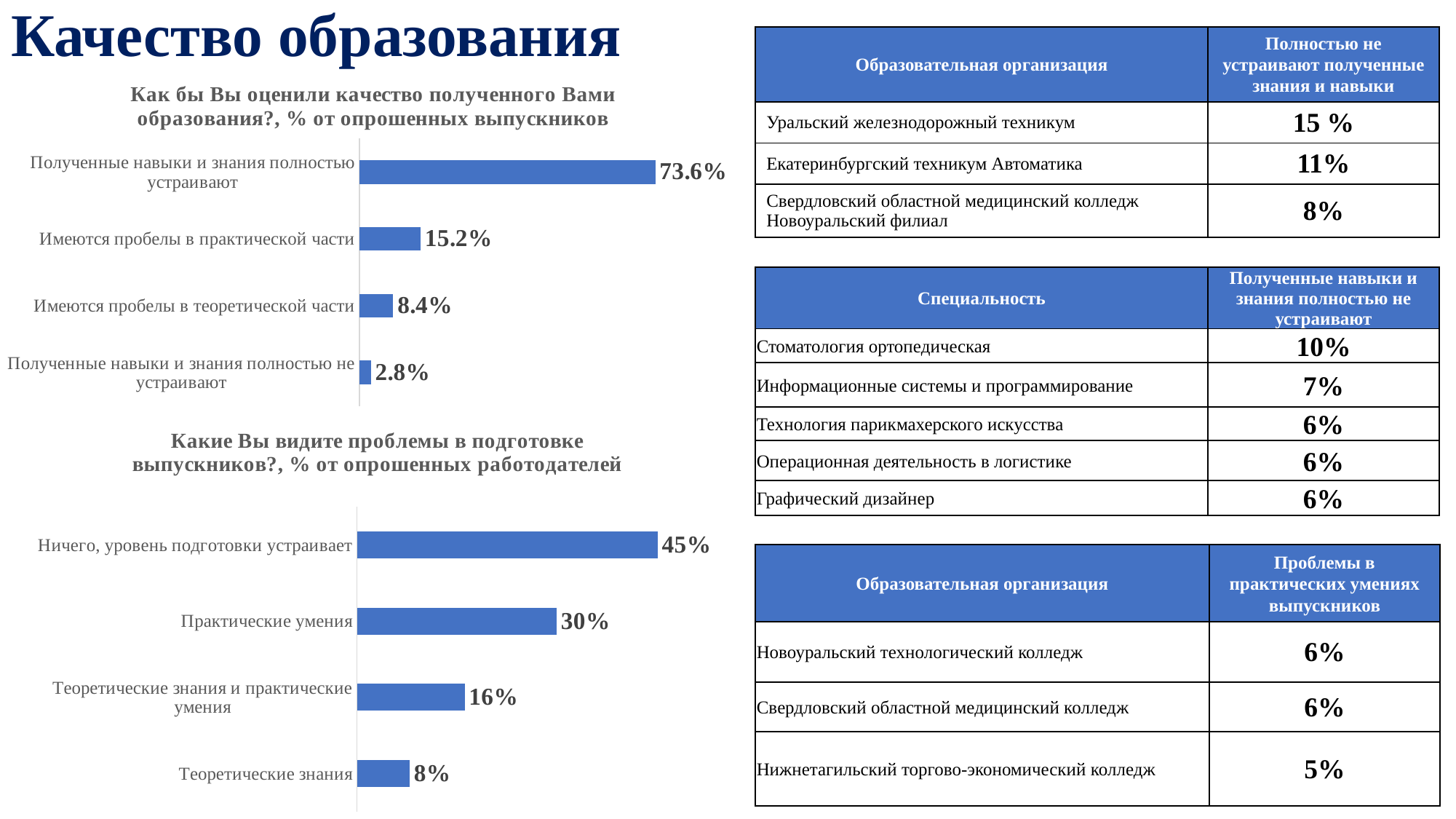
In the bottom chart ("Какие Вы видите проблемы в подготовке выпускников?"), what is the value for "Теоретические знания"? 8% In the top chart ("Как бы Вы оценили качество полученного Вами образования?"), what is the value for "Полученные навыки и знания полностью устраивают"? 73.6% What type of chart is the top chart ("Как бы Вы оценили качество полученного Вами образования?")? Bar chart In the top chart ("Как бы Вы оценили качество полученного Вами образования?"), what is the difference between "Имеются пробелы в практической части" and "Имеются пробелы в теоретической части"? 6.8% In the bottom chart ("Какие Вы видите проблемы в подготовке выпускников?"), what is the difference between "Ничего, уровень подготовки устраивает" and "Практические умения"? 15% In the bottom chart ("Какие Вы видите проблемы в подготовке выпускников?"), which category has the highest value? Ничего, уровень подготовки устраивает In the bottom chart ("Какие Вы видите проблемы в подготовке выпускников?"), how many categories are shown? 4 In the top chart ("Как бы Вы оценили качество полученного Вами образования?"), how many categories are shown? 4 In the top chart ("Как бы Вы оценили качество полученного Вами образования?"), what is the value for "Имеются пробелы в практической части"? 15.2% In the bottom chart ("Какие Вы видите проблемы в подготовке выпускников?"), which is larger: "Практические умения" or "Теоретические знания и практические умения"? Практические умения In the bottom chart ("Какие Вы видите проблемы в подготовке выпускников?"), what is the value for "Практические умения"? 30% In the top chart ("Как бы Вы оценили качество полученного Вами образования?"), which category has the lowest value? Полученные навыки и знания полностью не устраивают